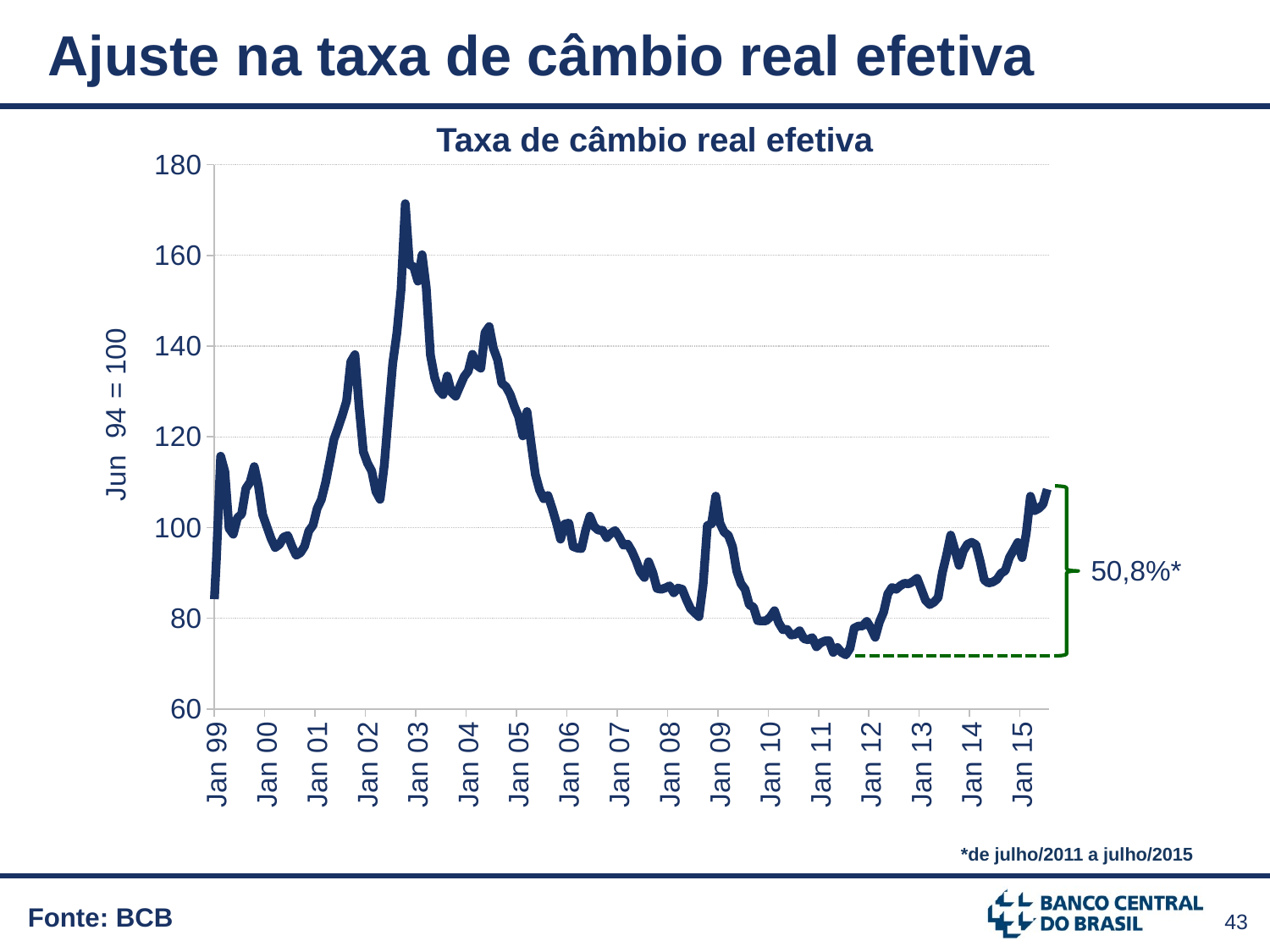
Is the value at the start of the series (Jan 99) greater or less than 100? less How many year labels are shown on the x axis? 17 Between which two x-axis labels does the series reach its highest value? Jan 02 and Jan 03 What is the title of the chart? Taxa de câmbio real efetiva What percentage change is annotated on the right side of the chart for July 2011 to July 2015? 50,8%* Between which two x-axis labels does the series reach its lowest value? Jan 11 and Jan 12 Does the series generally rise or fall between Jan 03 and Jan 11? fall What is the label on the vertical axis of the chart? Jun 94 = 100 What kind of chart is shown on the slide? line chart Is the value around Jan 14 greater or less than 80? greater Is the value around Jan 11 greater or less than 80? less